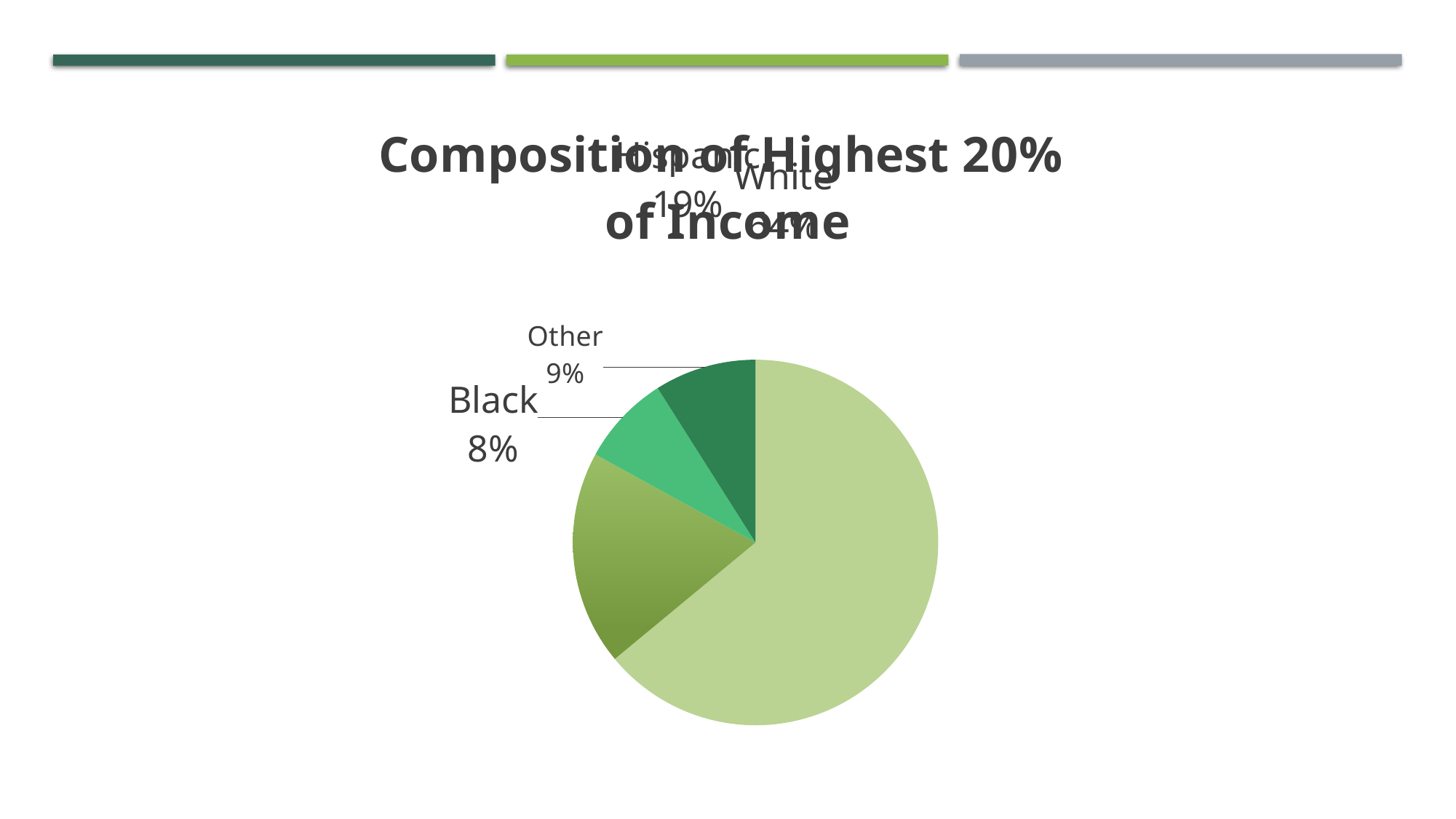
How many slices does the pie chart have? 4 What kind of chart is shown on the slide? pie chart Which category has the smallest slice of the pie? Black What share of the pie does the Black slice represent? 8% What is the title of the chart? Composition of Highest 20% of Income Which category has the largest slice of the pie? White What share of the pie does the Other slice represent? 9% Which slice is larger, Other or Black? Other What is the difference between the Other share and the Black share? 1% Which slice is larger, Hispanic or Other? Hispanic What share of the pie does the Hispanic slice represent? 19% What is the difference between the Hispanic share and the Other share? 10%